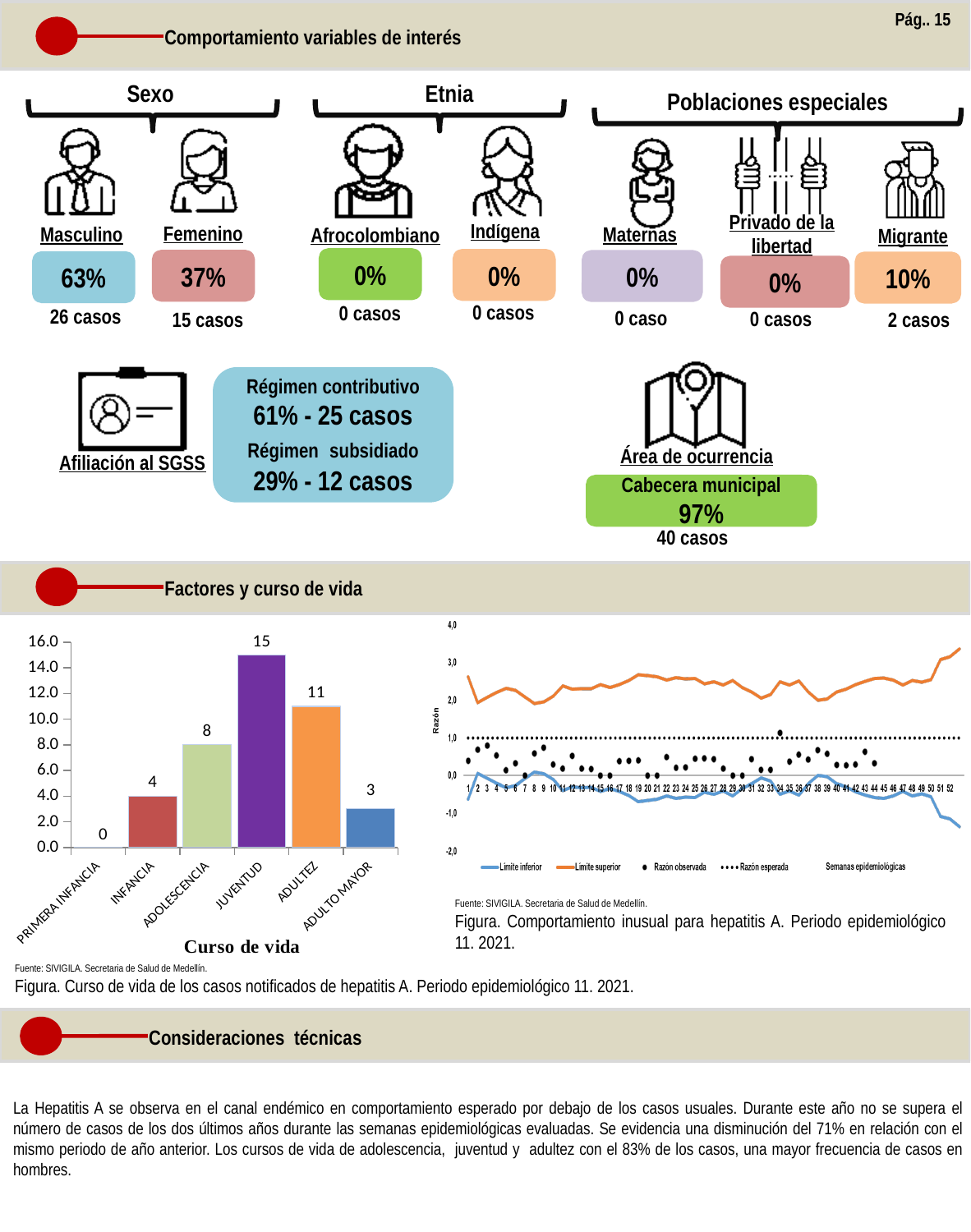
In the bar chart 'Curso de vida', what is the value for JUVENTUD? 15 In the bar chart 'Curso de vida', what is the difference between the values for JUVENTUD and ADULTEZ? 4 In the line chart on the right (Comportamiento inusual para hepatitis A), is the value of 'Límite superior' at week 52 greater or less than 3,0? greater In the bar chart 'Curso de vida', what is the value for ADULTEZ? 11 How many series does the legend of the line chart on the right (Comportamiento inusual para hepatitis A) list? 4 What kind of chart is the 'Curso de vida' chart on the left? Bar chart In the bar chart 'Curso de vida', which category has the highest value? JUVENTUD How many categories are shown in the bar chart 'Curso de vida'? 6 In the bar chart 'Curso de vida', what is the value for INFANCIA? 4 In the bar chart 'Curso de vida', which category has the lowest value? PRIMERA INFANCIA What is the label of the y axis of the line chart on the right (Comportamiento inusual para hepatitis A)? Razón In the bar chart 'Curso de vida', which is larger, the value for ADOLESCENCIA or the value for ADULTO MAYOR? ADOLESCENCIA